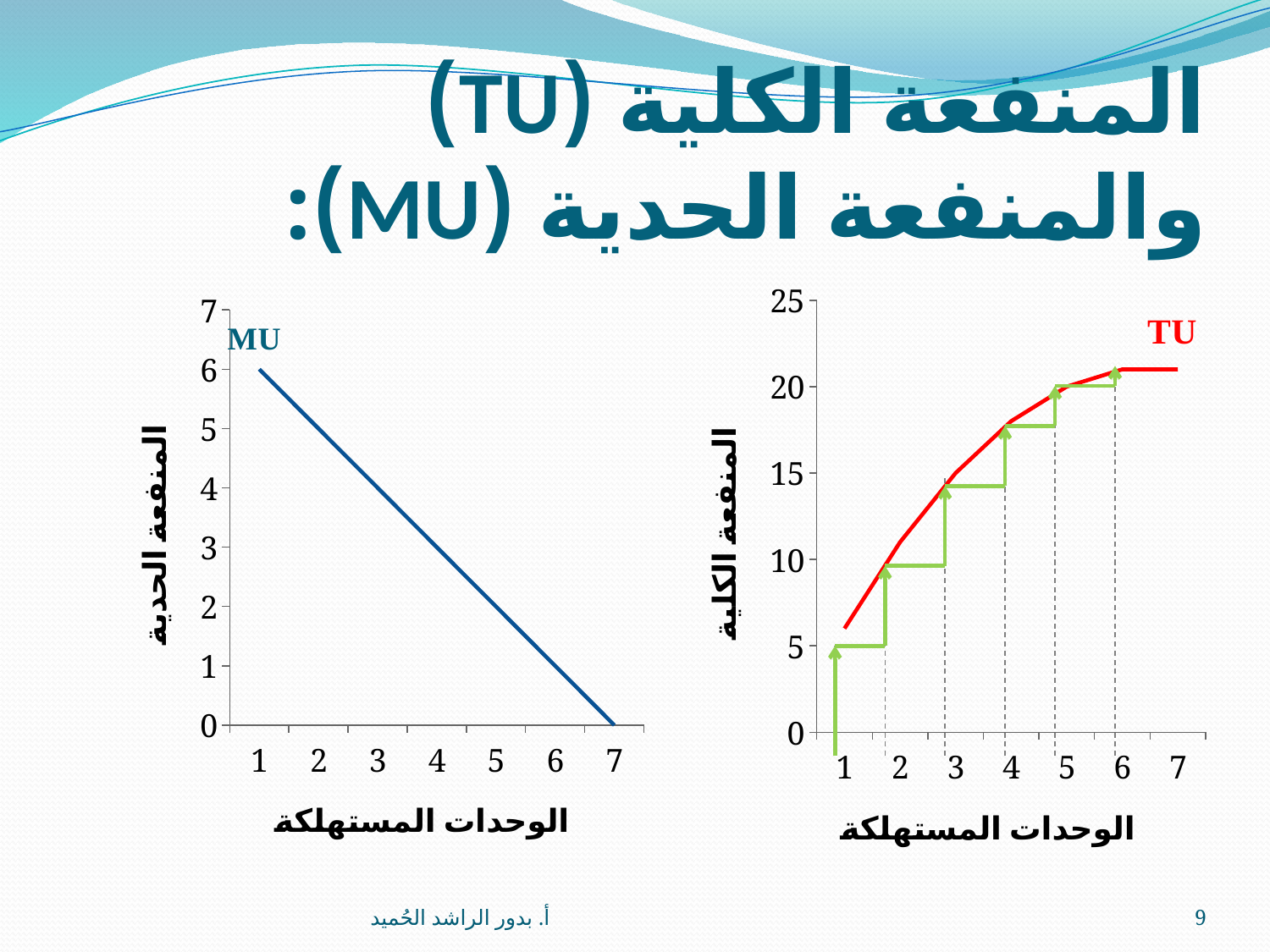
In the right chart, what colour is the TU curve? red In the left chart (MU), what is the marginal utility at 1 unit consumed? 6 What kind of chart is the right chart (TU)? line chart In the left chart (MU), how many units are marked on the x axis? 7 In the right chart (TU), is the total utility at 7 units greater or less than 20? greater In the left chart (MU), do the values rise or fall as the number of units consumed increases? fall In the left chart (MU), is the marginal utility at 4 units greater or less than 5? less In the right chart (TU), do the values rise or fall as the number of units consumed increases? rise What kind of chart is the left chart (MU)? line chart In the left chart (MU), what is the marginal utility at 7 units consumed? 0 In the right chart (TU), how many units are marked on the x axis? 7 In the right chart (TU), is the total utility at 1 unit greater or less than 10? less